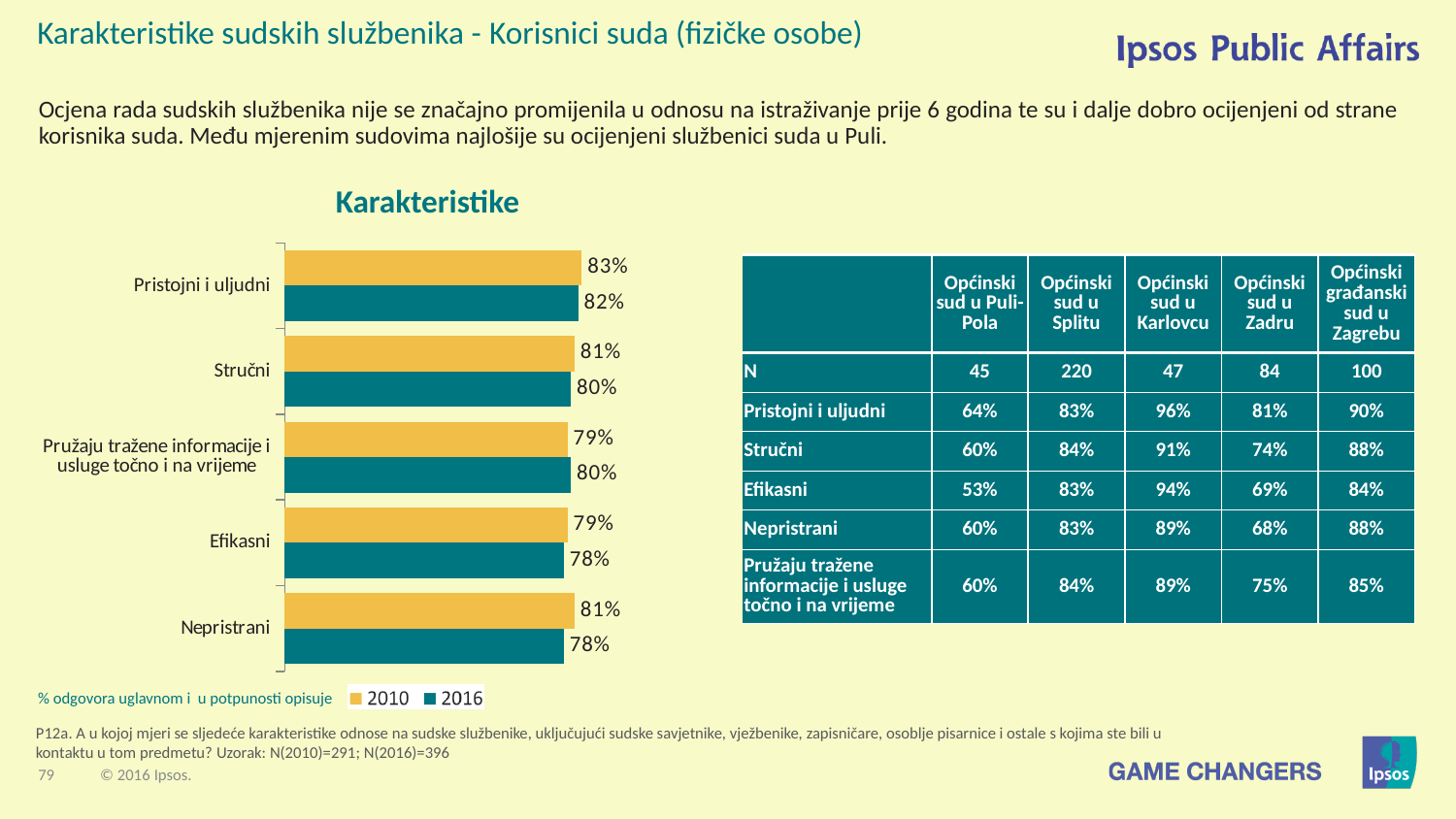
What is the 2010 value for Nepristrani? 81% What is the 2016 value for Pristojni i uljudni? 82% Which category has the highest 2016 value? Pristojni i uljudni How many categories are shown in the chart? 5 How many series does the legend list? 2 What type of chart is shown? Bar chart What is the title of the chart? Karakteristike For Pružaju tražene informacije i usluge točno i na vrijeme, which is larger: the 2010 value or the 2016 value? 2016 What is the difference between the 2010 and 2016 values for Nepristrani? 3% What is the 2016 value for Pružaju tražene informacije i usluge točno i na vrijeme? 80% What is the 2010 value for Efikasni? 79%